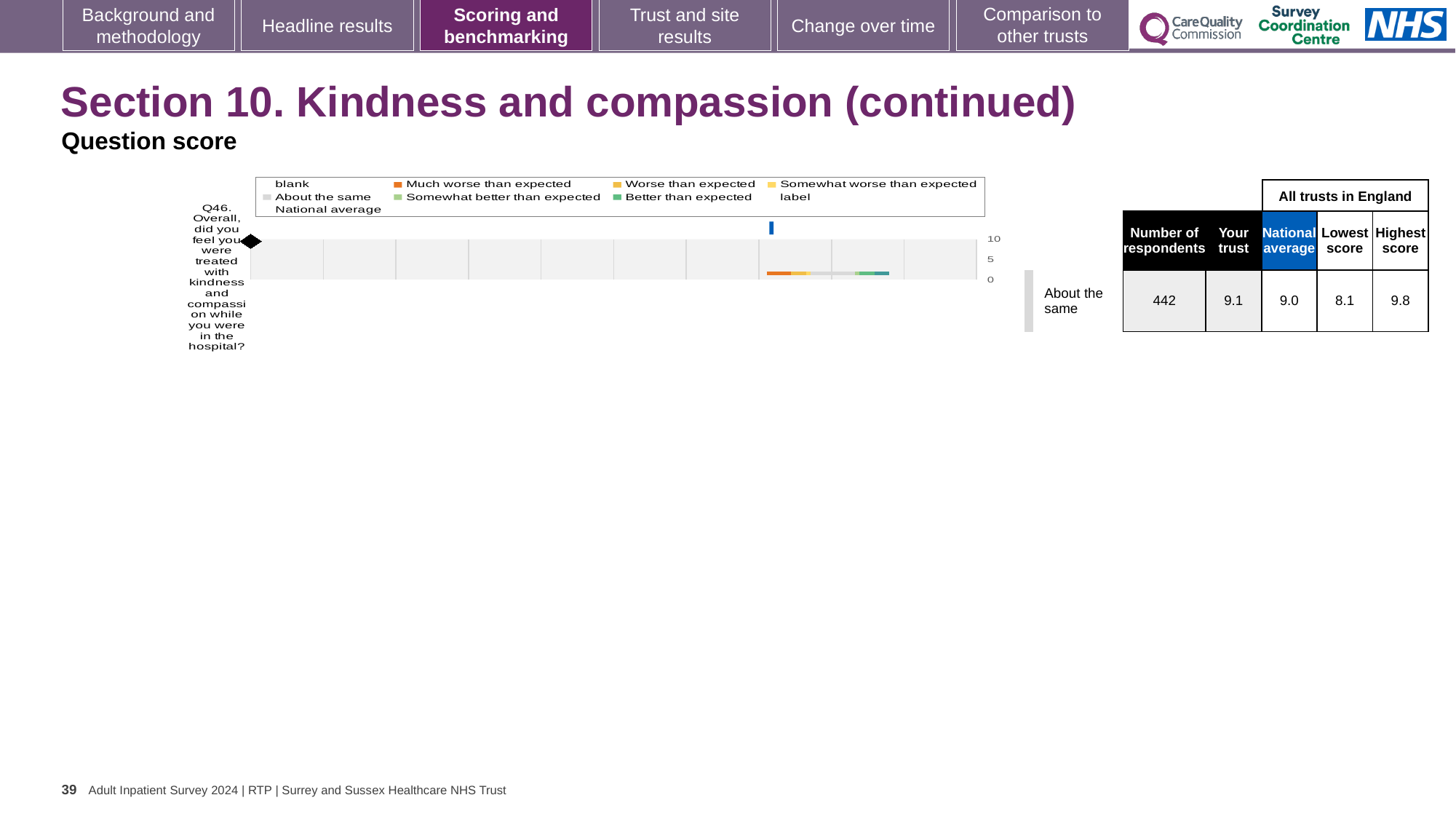
How many questions are plotted on the chart? 1 How many respondents answered Q46? 442 What is the 'Your trust' score for Q46 (treated with kindness and compassion)? 9.1 What kind of chart is used to show the Q46 question score? bar chart What is the lowest score among all trusts in England for Q46? 8.1 What is the highest score among all trusts in England for Q46? 9.8 What is the national average score for Q46? 9.0 Which benchmark category is the trust's Q46 score placed in? About the same Which legend entry is shown in orange on the chart? Much worse than expected What is the difference between the highest and lowest scores for Q46 across all trusts in England? 1.7 By how much does the 'Your trust' score for Q46 exceed the national average? 0.1 Which is larger for Q46, the 'Your trust' score or the national average? Your trust